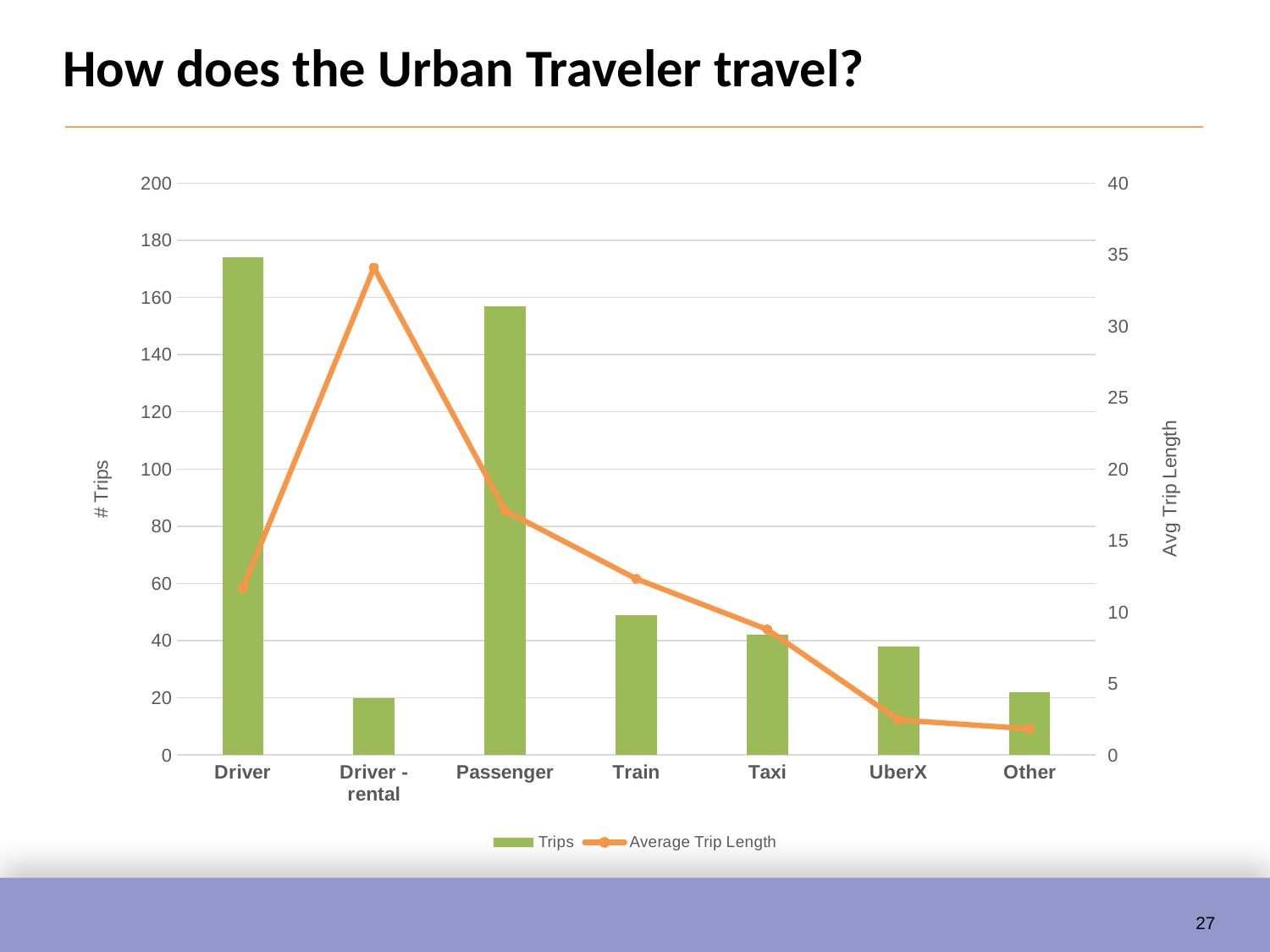
How many travel mode categories are shown on the x axis? 7 How many series does the legend list? 2 What is the title of the right-hand vertical axis? Avg Trip Length Which travel mode has the highest average trip length? Driver - rental Is the average trip length for Driver - rental greater or less than 30? greater Which travel mode has the highest number of trips? Driver Is the number of trips for Train greater or less than 60? less Is the number of trips for Passenger greater or less than 140? greater Which has more trips, Driver or Passenger? Driver Which travel mode has the lowest number of trips? Driver - rental What kind of chart is shown on the slide? A bar chart combined with a line